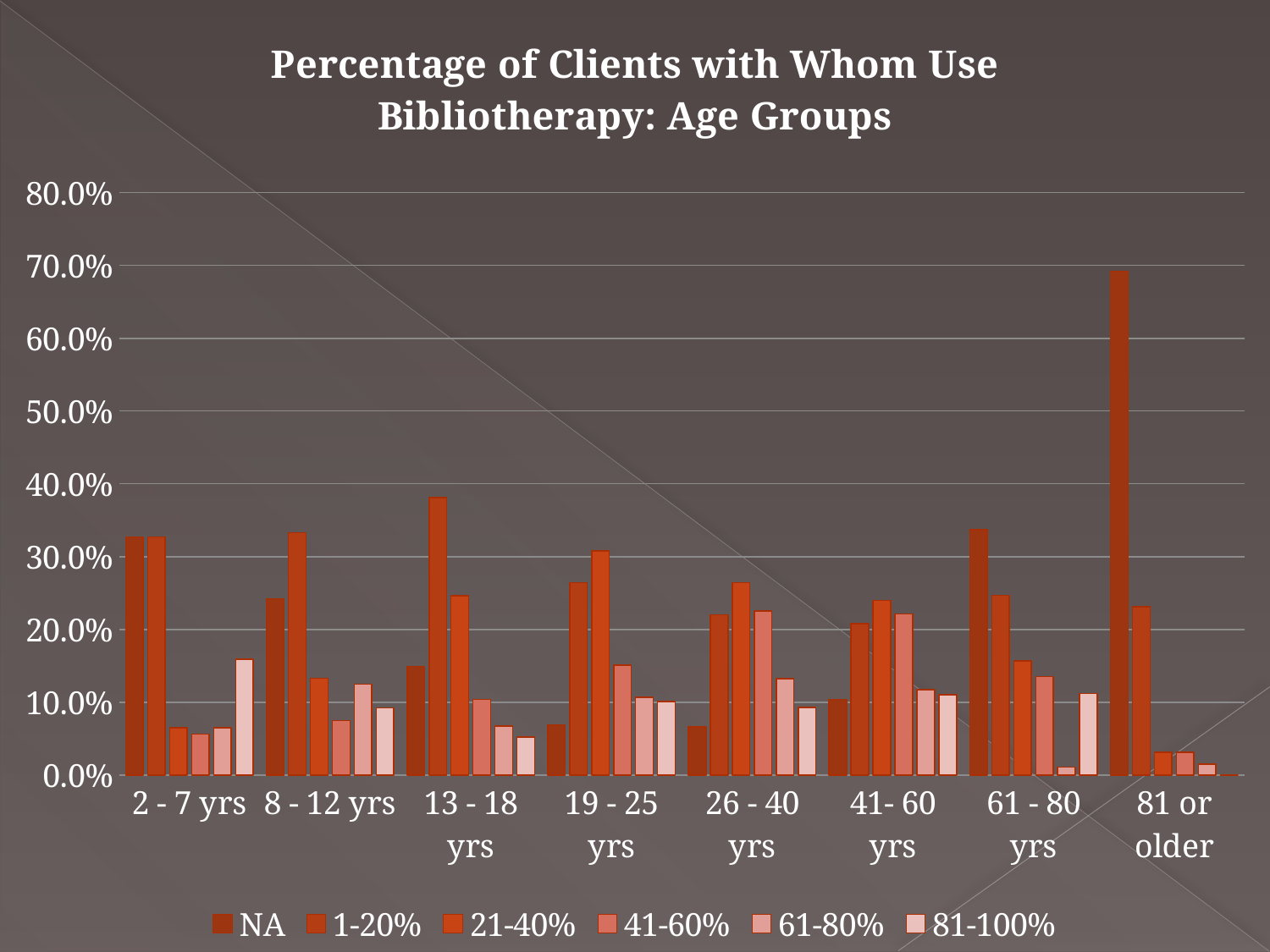
For the 19 - 25 yrs group, which is larger: the 21-40% bar or the NA bar? 21-40% What kind of chart is shown on the slide? bar chart How many age groups are shown along the x axis? 8 How many series does the legend list? 6 Is the 21-40% value for the 2 - 7 yrs group greater or less than 10.0%? less What is the title of the chart? Percentage of Clients with Whom Use Bibliotherapy: Age Groups Which age group has the lowest 81-100% bar? 81 or older Is the NA value for the 81 or older group greater or less than 60.0%? greater Is the 1-20% value for the 13 - 18 yrs group greater or less than 30.0%? greater For the 8 - 12 yrs group, which is larger: the 1-20% bar or the NA bar? 1-20% What is the first entry listed in the legend? NA Which age group has the highest NA bar? 81 or older